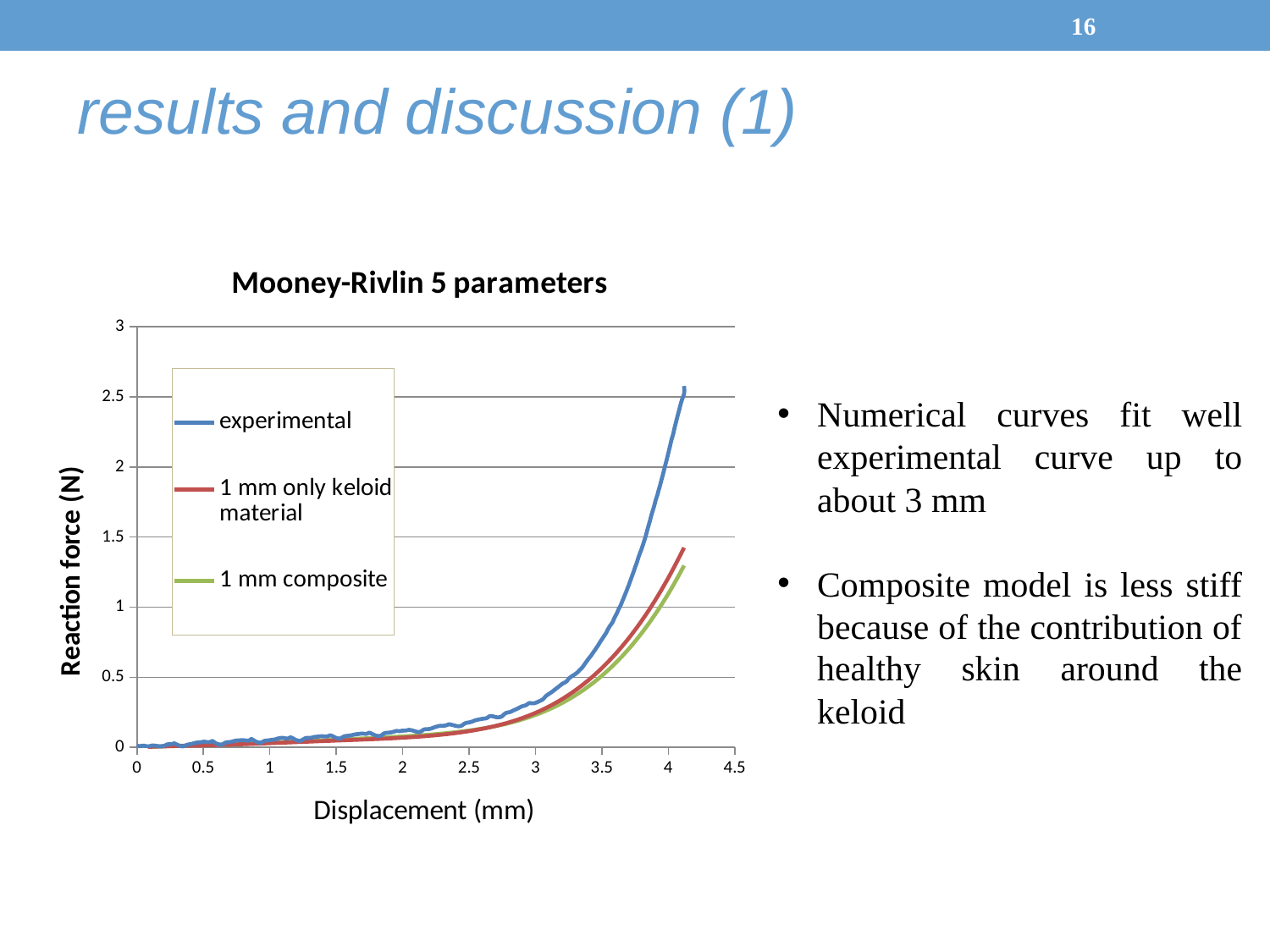
Which series is plotted in blue? experimental Do the values of the experimental series rise or fall as displacement increases? rise At a displacement of 4 mm, which series has the larger reaction force: 1 mm only keloid material or 1 mm composite? 1 mm only keloid material At a displacement of 4 mm, is the reaction force for the experimental series greater or less than 1.5 N? greater What kind of chart is shown on the slide? line chart What is the title of the chart? Mooney-Rivlin 5 parameters Which series has the lowest reaction force at a displacement of 4 mm? 1 mm composite At a displacement of 4 mm, is the reaction force for the 1 mm composite series greater or less than 1.5 N? less What is the label of the y axis? Reaction force (N) At a displacement of 3 mm, is the reaction force for the experimental series greater or less than 0.5 N? less How many series does the legend list? 3 Which series reaches the highest reaction force at the right end of the chart? experimental